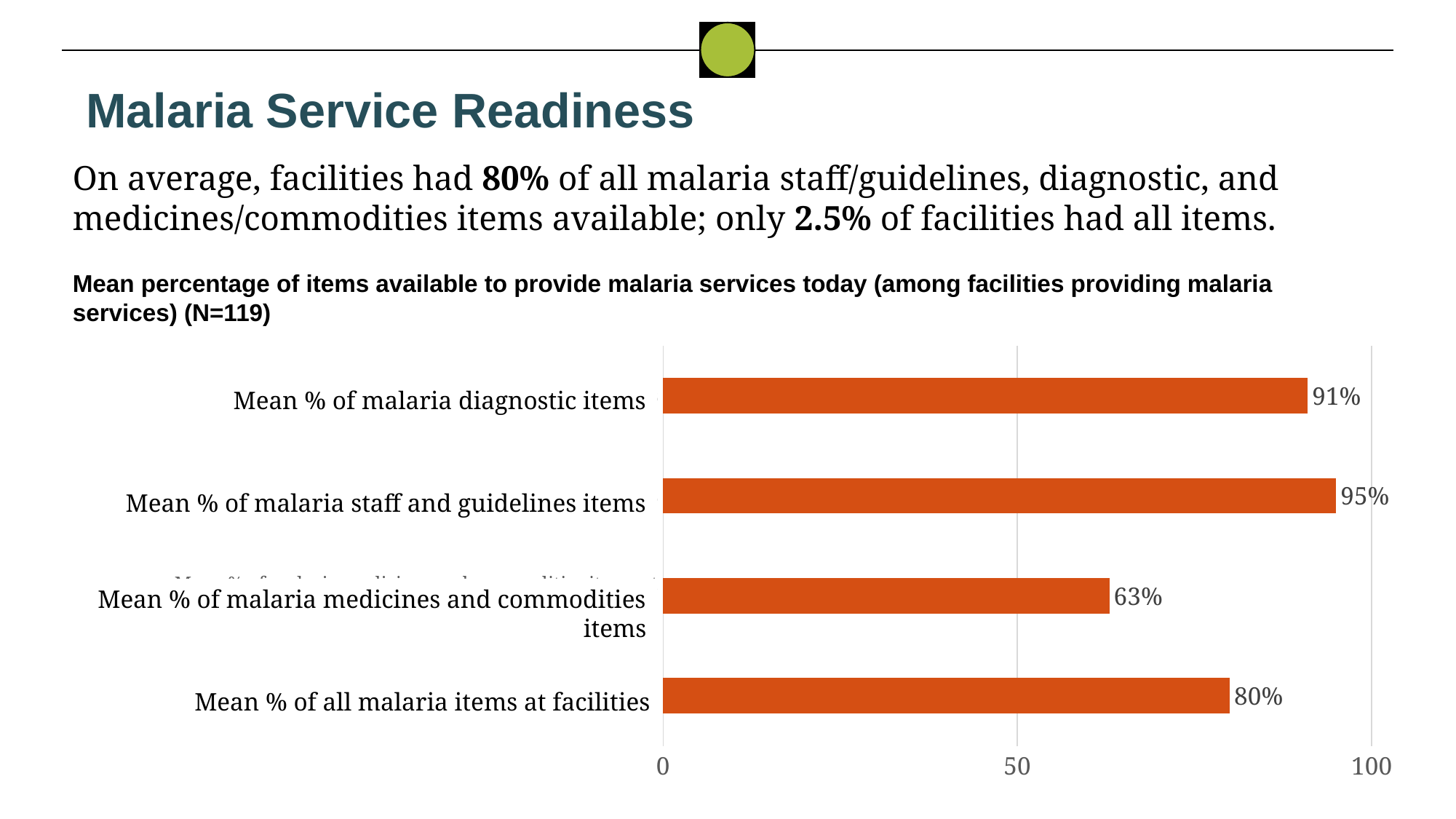
How many categories are shown in the chart? 4 What is the mean % of malaria staff and guidelines items? 95% What is the mean % of malaria medicines and commodities items? 63% What kind of chart is shown on the slide? Bar chart What is the difference between the mean % of malaria staff and guidelines items and the mean % of malaria medicines and commodities items? 32% Which category has the lowest mean percentage? Mean % of malaria medicines and commodities items Is the value for mean % of malaria medicines and commodities items greater or less than 50? greater Which is larger: the mean % of malaria diagnostic items or the mean % of all malaria items at facilities? Mean % of malaria diagnostic items Which category has the highest mean percentage? Mean % of malaria staff and guidelines items What is the sample size (N) stated in the chart title? 119 What is the mean % of malaria diagnostic items? 91% What is the mean % of all malaria items at facilities? 80%